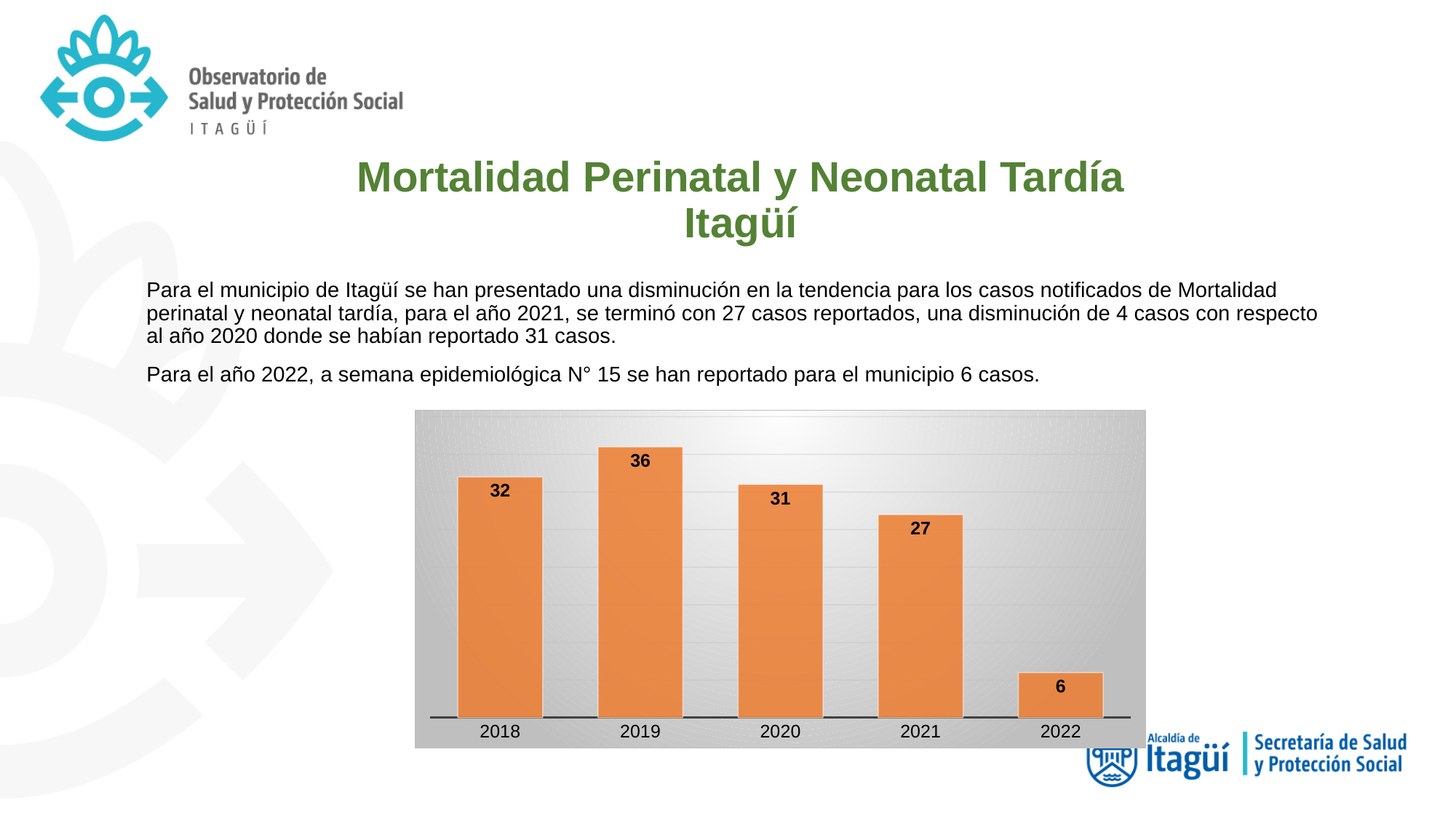
Which is larger, the value for 2018 or the value for 2020? 2018 What is the value shown for 2021? 27 What is the difference between the values for 2020 and 2021? 4 What is the difference between the values for 2019 and 2018? 4 Do the values rise or fall from 2019 to 2022? Fall What kind of chart is shown on the slide? Bar chart How many years are shown on the x axis? 5 Which year has the highest value? 2019 Which year has the lowest value? 2022 What is the value shown for 2019? 36 What is the value shown for 2018? 32 What is the value shown for 2022? 6